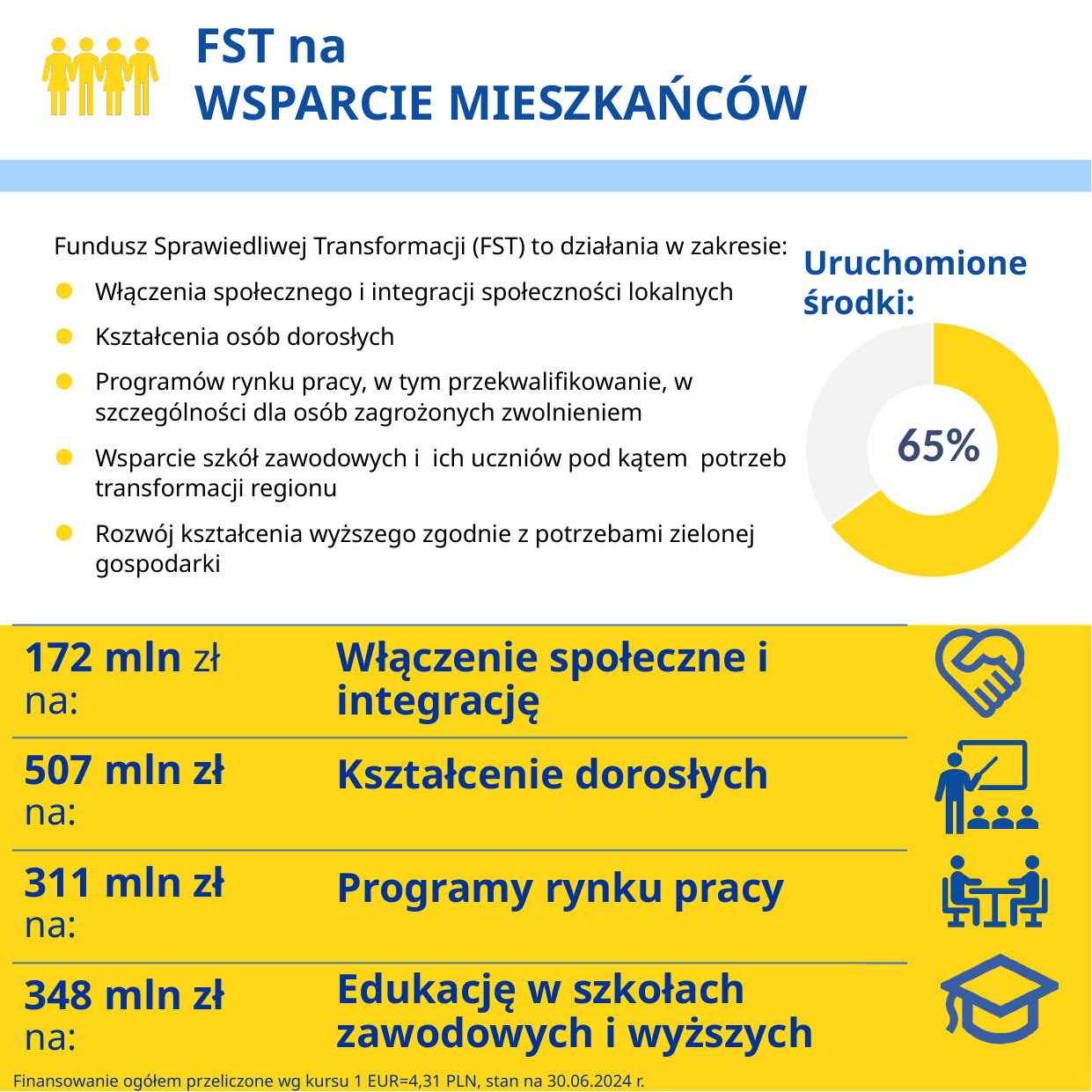
What colour is the larger slice of the donut chart? yellow Is the yellow slice of the donut chart greater or less than 50%? greater What share of the donut chart does the yellow slice represent? 65% Which slice of the donut chart is larger, the yellow one or the grey one? the yellow one What kind of chart is shown under the heading "Uruchomione środki:"? pie chart (donut) What is the heading printed above the donut chart? Uruchomione środki: What percentage is printed in the centre of the donut chart? 65% How many slices does the donut chart have? 2